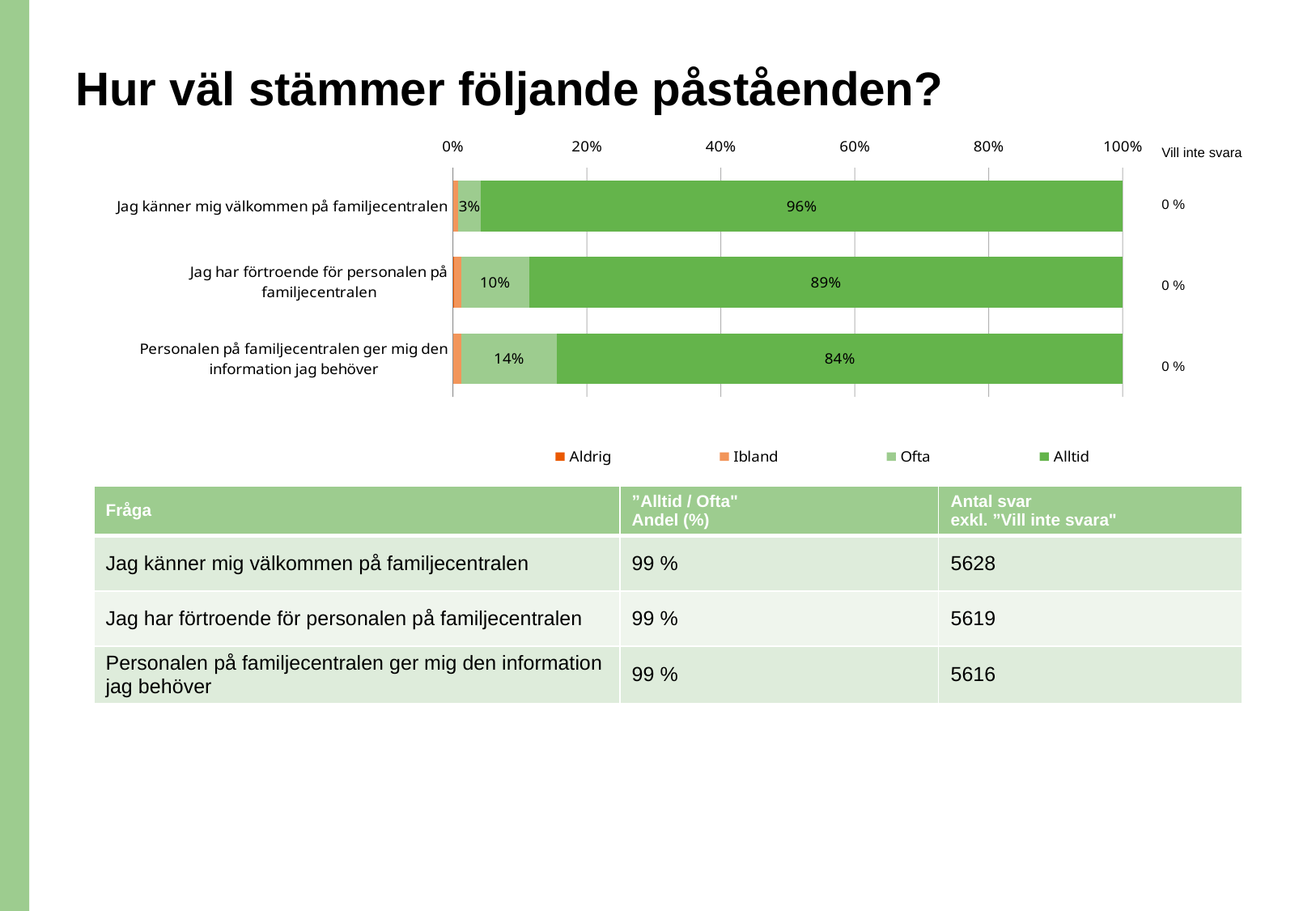
What is the "Ofta" value for "Jag har förtroende för personalen på familjecentralen"? 10% Which statement has the highest "Alltid" value? Jag känner mig välkommen på familjecentralen What is the "Ofta" value for "Personalen på familjecentralen ger mig den information jag behöver"? 14% What kind of chart is shown on the slide? Stacked bar chart What is the difference between the "Alltid" values for "Jag känner mig välkommen på familjecentralen" and "Personalen på familjecentralen ger mig den information jag behöver"? 12% How many series does the chart legend list? 4 Which is larger: the "Alltid" value for "Jag har förtroende för personalen på familjecentralen" or for "Personalen på familjecentralen ger mig den information jag behöver"? Jag har förtroende för personalen på familjecentralen How many statements (categories) are shown in the chart? 3 What is the "Alltid" value for "Personalen på familjecentralen ger mig den information jag behöver"? 84% What is the "Vill inte svara" value shown for "Jag har förtroende för personalen på familjecentralen"? 0 % What is the "Alltid" value for "Jag känner mig välkommen på familjecentralen"? 96% Which statement has the lowest "Ofta" value? Jag känner mig välkommen på familjecentralen